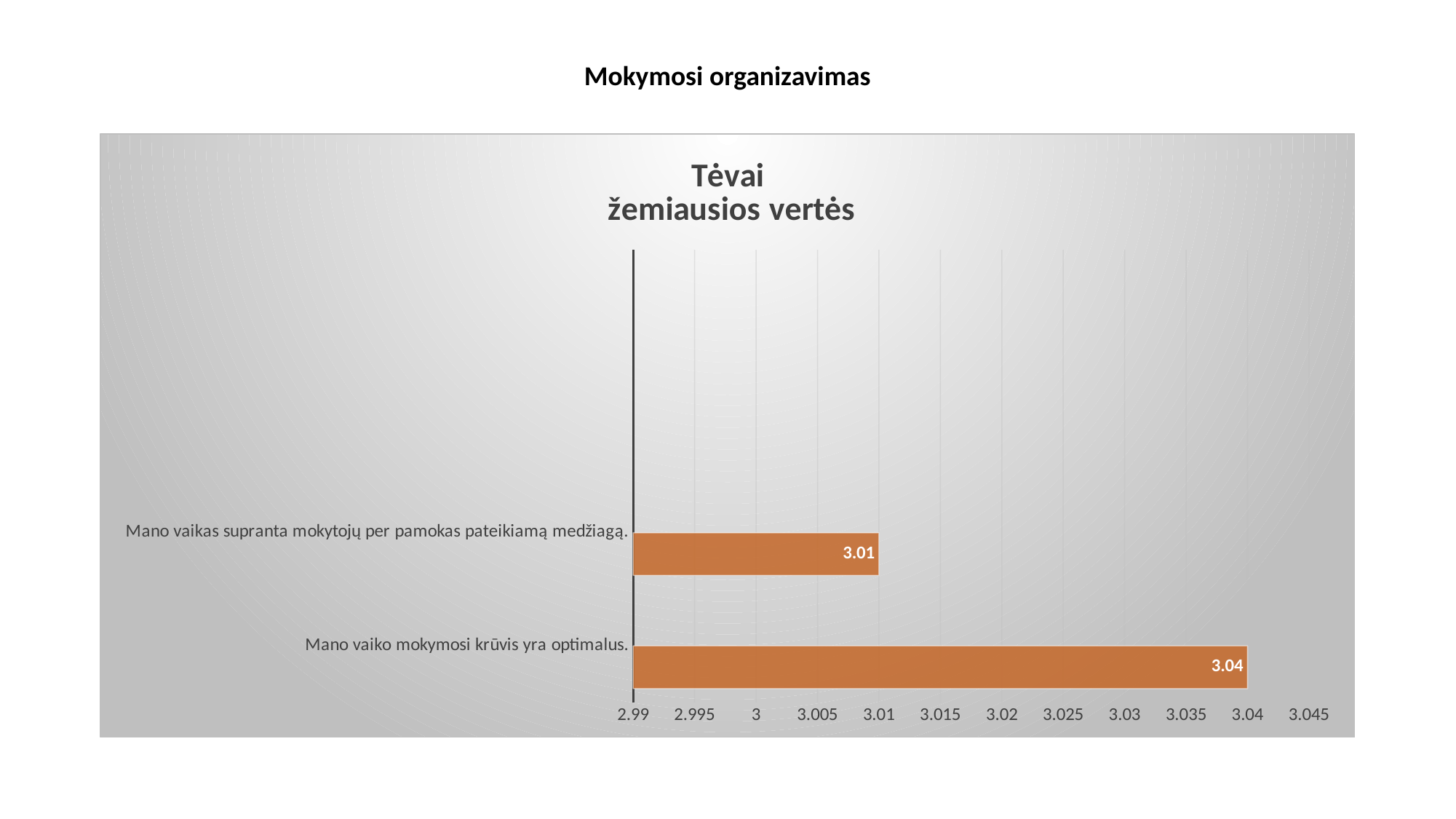
What is the value for "Mano vaiko mokymosi krūvis yra optimalus."? 3.04 What is the title of the slide? Mokymosi organizavimas What is the value for "Mano vaikas supranta mokytojų per pamokas pateikiamą medžiagą."? 3.01 How many categories are shown in the chart? 2 Is the value for "Mano vaiko mokymosi krūvis yra optimalus." greater or less than 3.03? greater Which category has the highest value? Mano vaiko mokymosi krūvis yra optimalus. Which category has the lowest value? Mano vaikas supranta mokytojų per pamokas pateikiamą medžiagą. What is the title of the chart? Tėvai žemiausios vertės What is the difference between the values for "Mano vaiko mokymosi krūvis yra optimalus." and "Mano vaikas supranta mokytojų per pamokas pateikiamą medžiagą."? 0.03 Which is larger: the value for "Mano vaiko mokymosi krūvis yra optimalus." or for "Mano vaikas supranta mokytojų per pamokas pateikiamą medžiagą."? Mano vaiko mokymosi krūvis yra optimalus. Is the value for "Mano vaikas supranta mokytojų per pamokas pateikiamą medžiagą." greater or less than 3.02? less What kind of chart is shown on the slide? bar chart